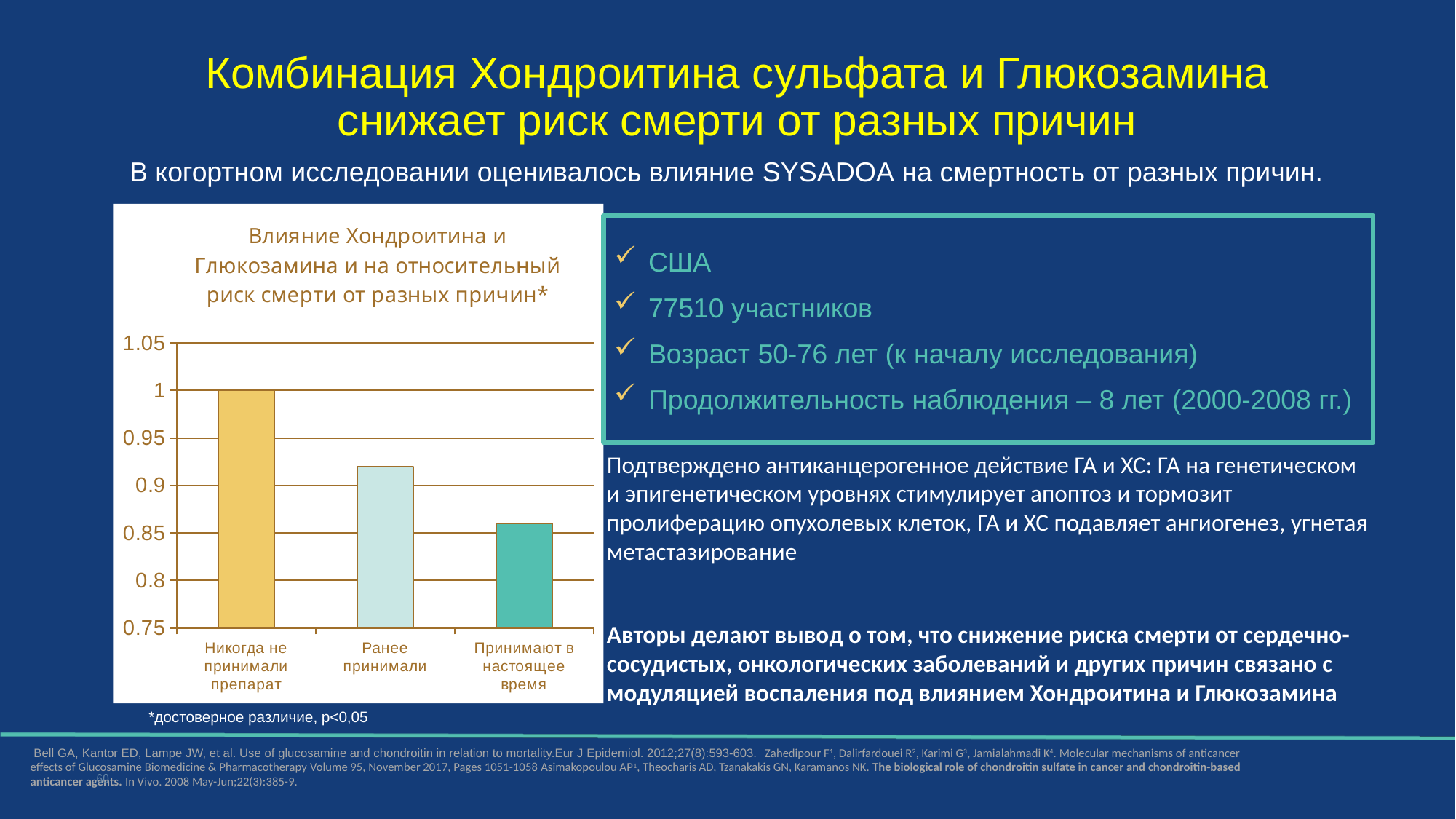
What kind of chart is shown on the slide? bar chart What is the lowest value shown on the chart's vertical axis? 0.75 What is the value for 'Никогда не принимали препарат' on the chart? 1 Is the value for 'Ранее принимали' greater or less than 0.9? greater Is the value for 'Ранее принимали' greater or less than 0.95? less How many categories are plotted on the chart? 3 Is the value for 'Принимают в настоящее время' greater or less than 0.9? less Which category has the lowest relative risk of death on the chart? Принимают в настоящее время Which is larger: the value for 'Ранее принимали' or the value for 'Принимают в настоящее время'? Ранее принимали Do the values rise or fall from left to right across the categories on the chart? fall Which category has the highest relative risk of death on the chart? Никогда не принимали препарат What is the title of the chart? Влияние Хондроитина и Глюкозамина и на относительный риск смерти от разных причин*